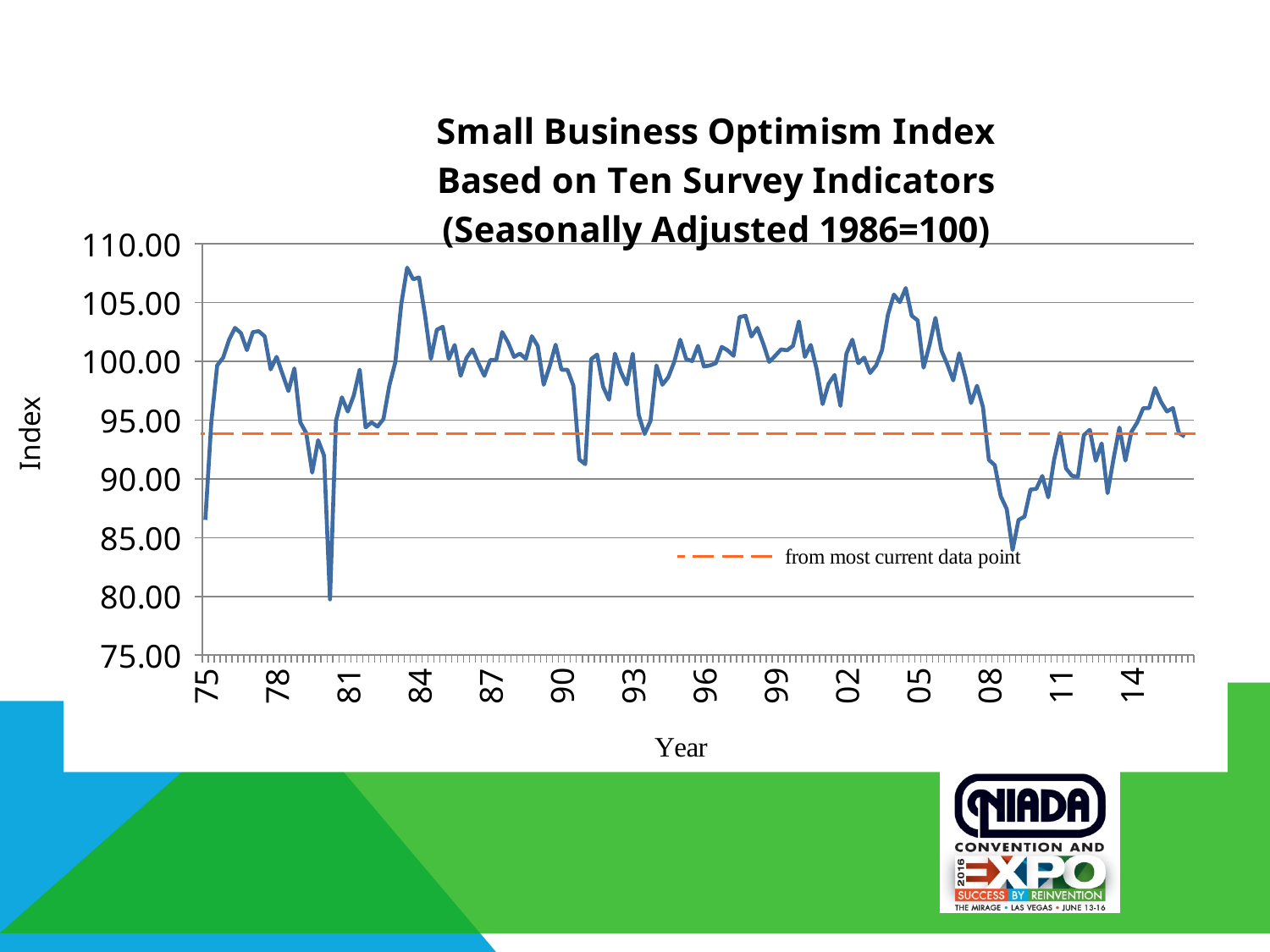
Which is higher: the peak of the index line around 1984 or the peak around 2005? the peak around 1984 What is the title of the chart? Small Business Optimism Index Based on Ten Survey Indicators (Seasonally Adjusted 1986=100) Is the dashed horizontal line labelled 'from most current data point' greater or less than 95.00? less Is the lowest point of the index line, around 1980, greater or less than 85.00? less What kind of chart is shown on the slide? line chart Does the index line generally rise or fall between 2009 and 2014? rise What label is shown on the vertical axis of the chart? Index Is the dashed horizontal line labelled 'from most current data point' greater or less than 90.00? greater What is the highest value shown on the vertical axis? 110.00 Does the index line rise or fall between 2008 and 2009? fall